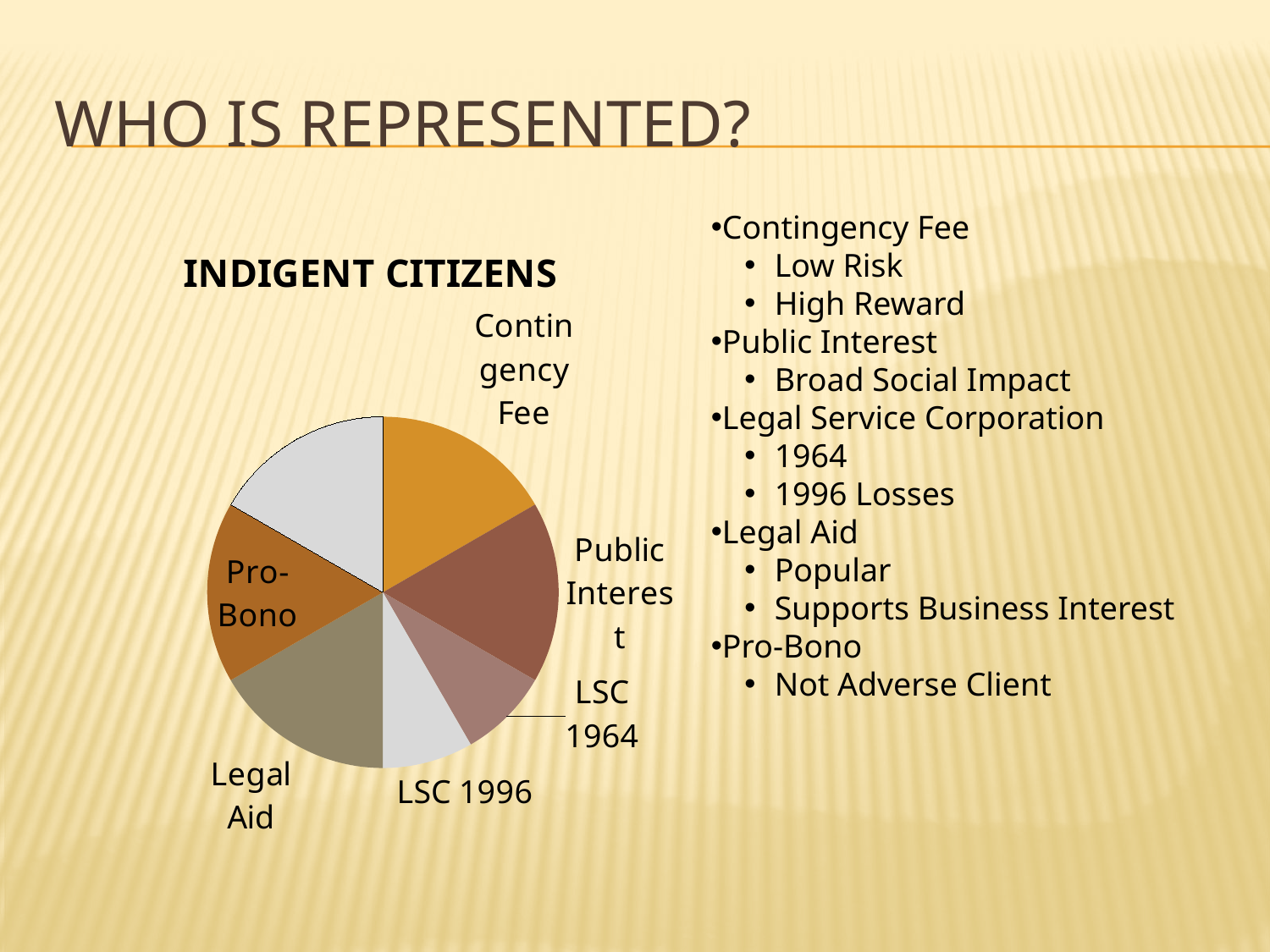
Which slice is larger, Public Interest or LSC 1996? Public Interest Which slice is larger, Legal Aid or LSC 1964? Legal Aid What is the title of the pie chart? INDIGENT CITIZENS Which slice is larger, Contingency Fee or LSC 1996? Contingency Fee How many labeled slices does the pie chart have? 6 What kind of chart is shown on the slide? pie chart What colour is the Contingency Fee slice of the pie chart? orange